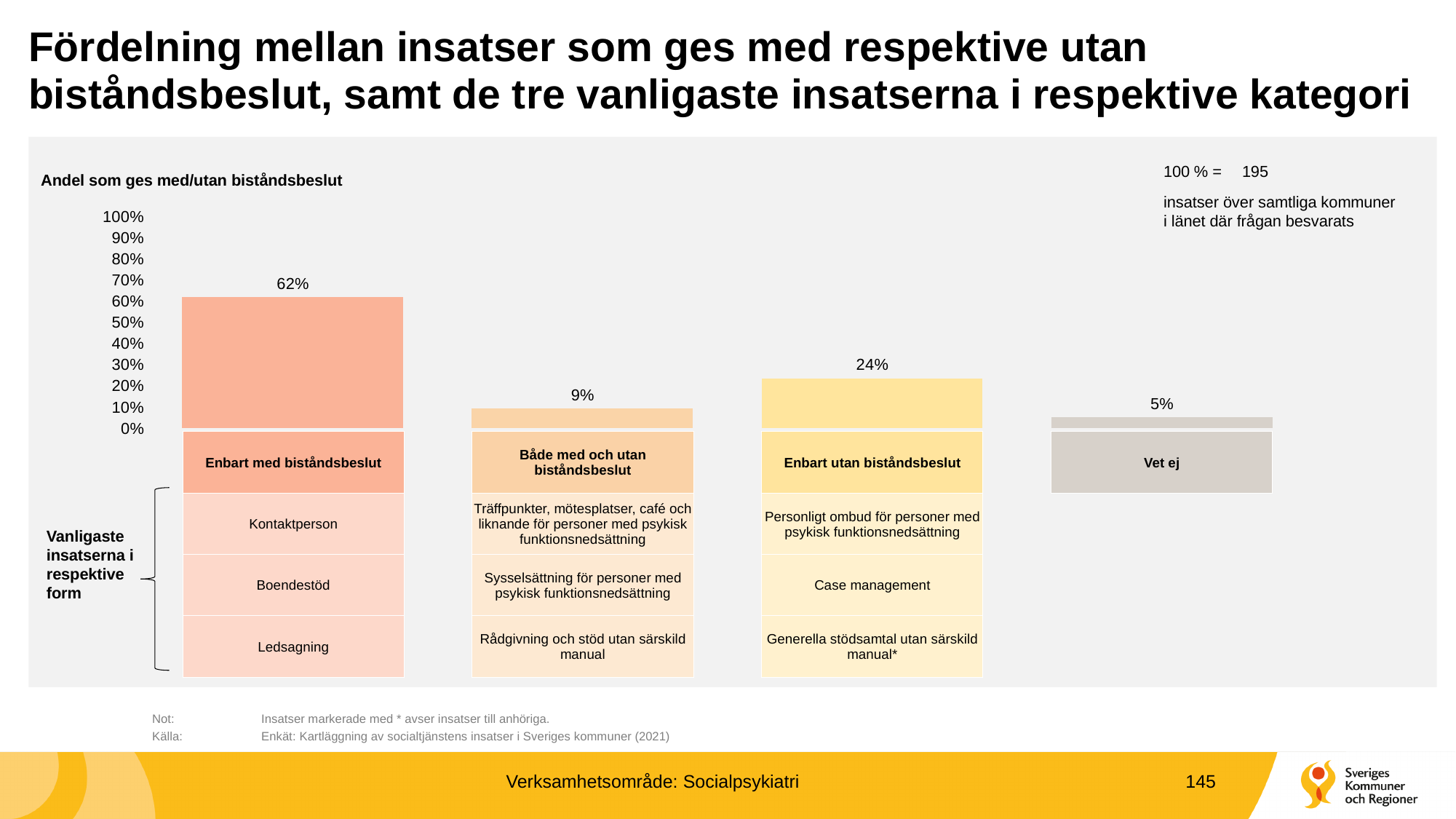
Which category has the highest value? Enbart med biståndsbeslut What does 100% correspond to according to the note on the chart? 195 insatser What is the value for "Både med och utan biståndsbeslut"? 9% Is the value for "Enbart med biståndsbeslut" greater or less than 50%? greater Which is larger, "Både med och utan biståndsbeslut" or "Enbart utan biståndsbeslut"? Enbart utan biståndsbeslut What is the value for "Vet ej"? 5% How many categories are shown in the chart? 4 Which category has the lowest value? Vet ej What is the value for "Enbart utan biståndsbeslut"? 24% What kind of chart is shown on the slide? Bar chart What is the value for "Enbart med biståndsbeslut"? 62% What is the difference between "Enbart med biståndsbeslut" and "Enbart utan biståndsbeslut"? 38 percentage points